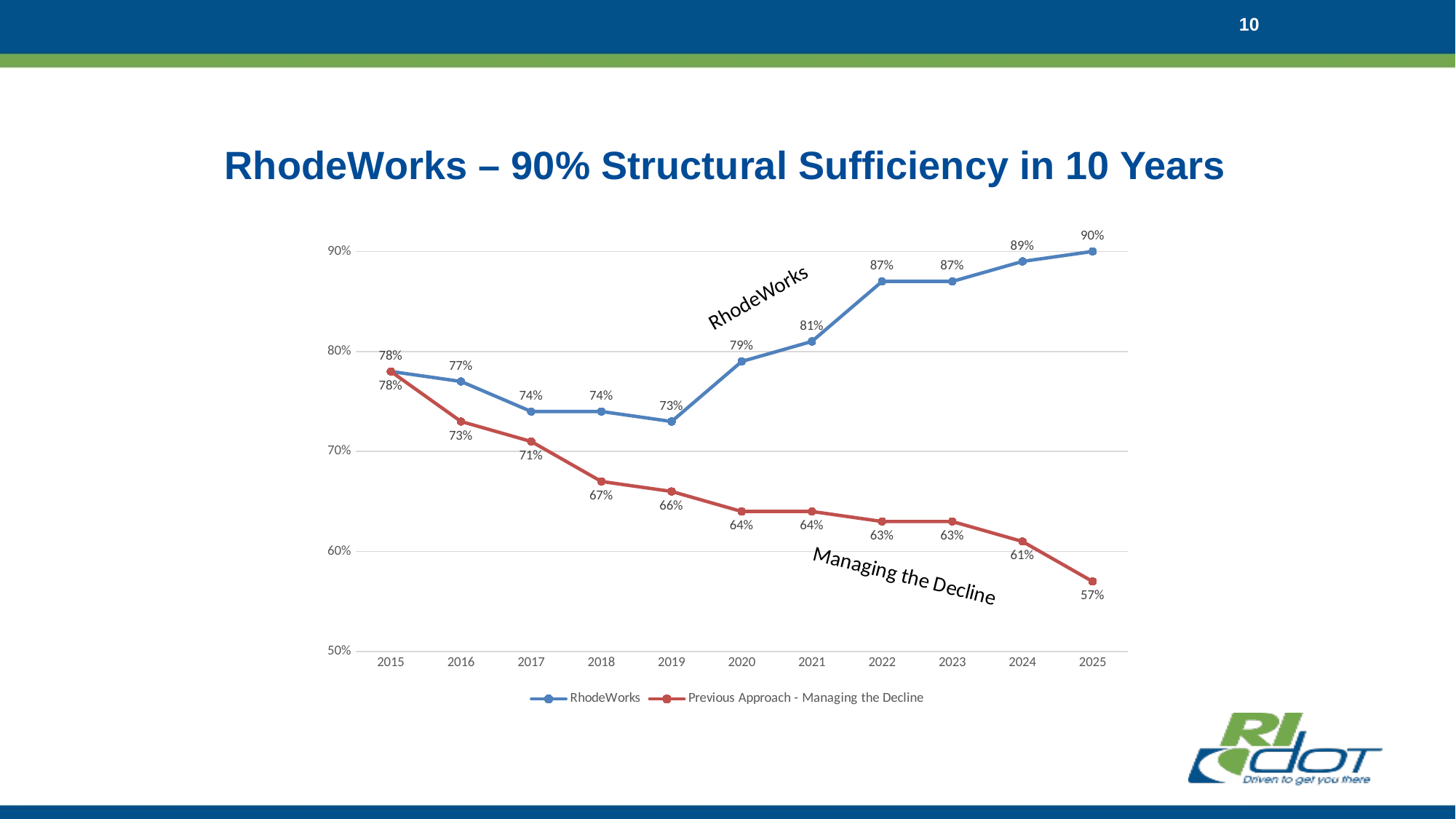
How many series does the legend list? 2 What is the difference between the RhodeWorks and Previous Approach - Managing the Decline values in 2025? 33% Which series has the higher value in 2022, RhodeWorks or Previous Approach - Managing the Decline? RhodeWorks What kind of chart is shown on the slide? Line chart In which year is the RhodeWorks series at its lowest value? 2019 What is the RhodeWorks value for 2021? 81% In which year is the Previous Approach - Managing the Decline series at its lowest value? 2025 How many years are shown on the x axis? 11 What is the title of the slide? RhodeWorks – 90% Structural Sufficiency in 10 Years What is the Previous Approach - Managing the Decline value for 2019? 66% What is the RhodeWorks value for 2025? 90% Does the Previous Approach - Managing the Decline series rise or fall from 2015 to 2025? Fall